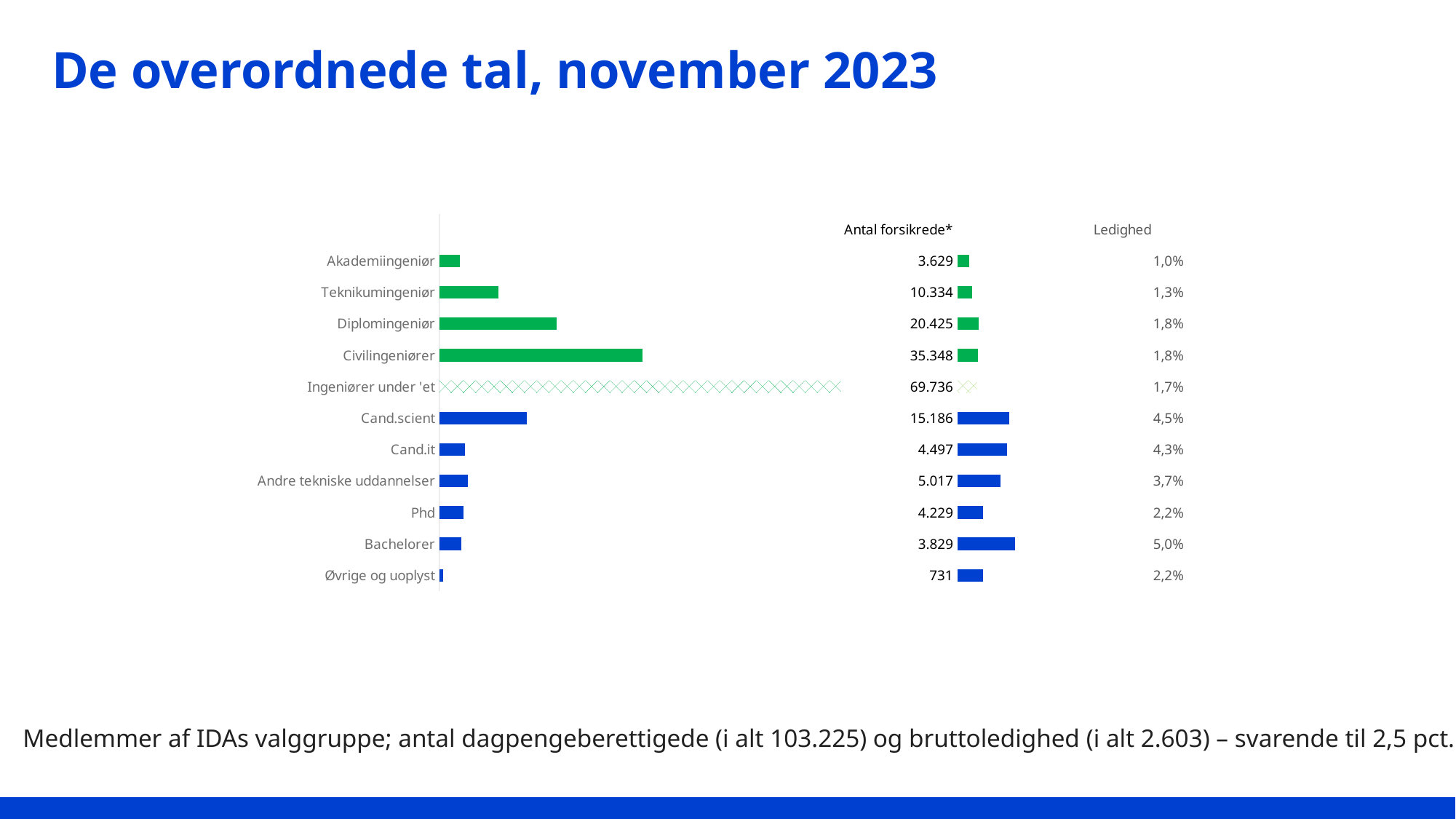
Which category has the lowest Antal forsikrede*? Øvrige og uoplyst What kind of chart is shown on the slide? Bar chart What is the Antal forsikrede* value for Civilingeniører? 35.348 What is the Antal forsikrede* value for Øvrige og uoplyst? 731 What is the Ledighed value for Cand.scient? 4,5% How many categories are listed in the chart? 11 Which has a higher Antal forsikrede*, Cand.it or Andre tekniske uddannelser? Andre tekniske uddannelser Which category has the highest Ledighed? Bachelorer Which category has the lowest Ledighed? Akademiingeniør What is the title of the slide containing the chart? De overordnede tal, november 2023 What is the difference in Antal forsikrede* between Civilingeniører and Diplomingeniør? 14.923 What is the Ledighed value for Teknikumingeniør? 1,3%